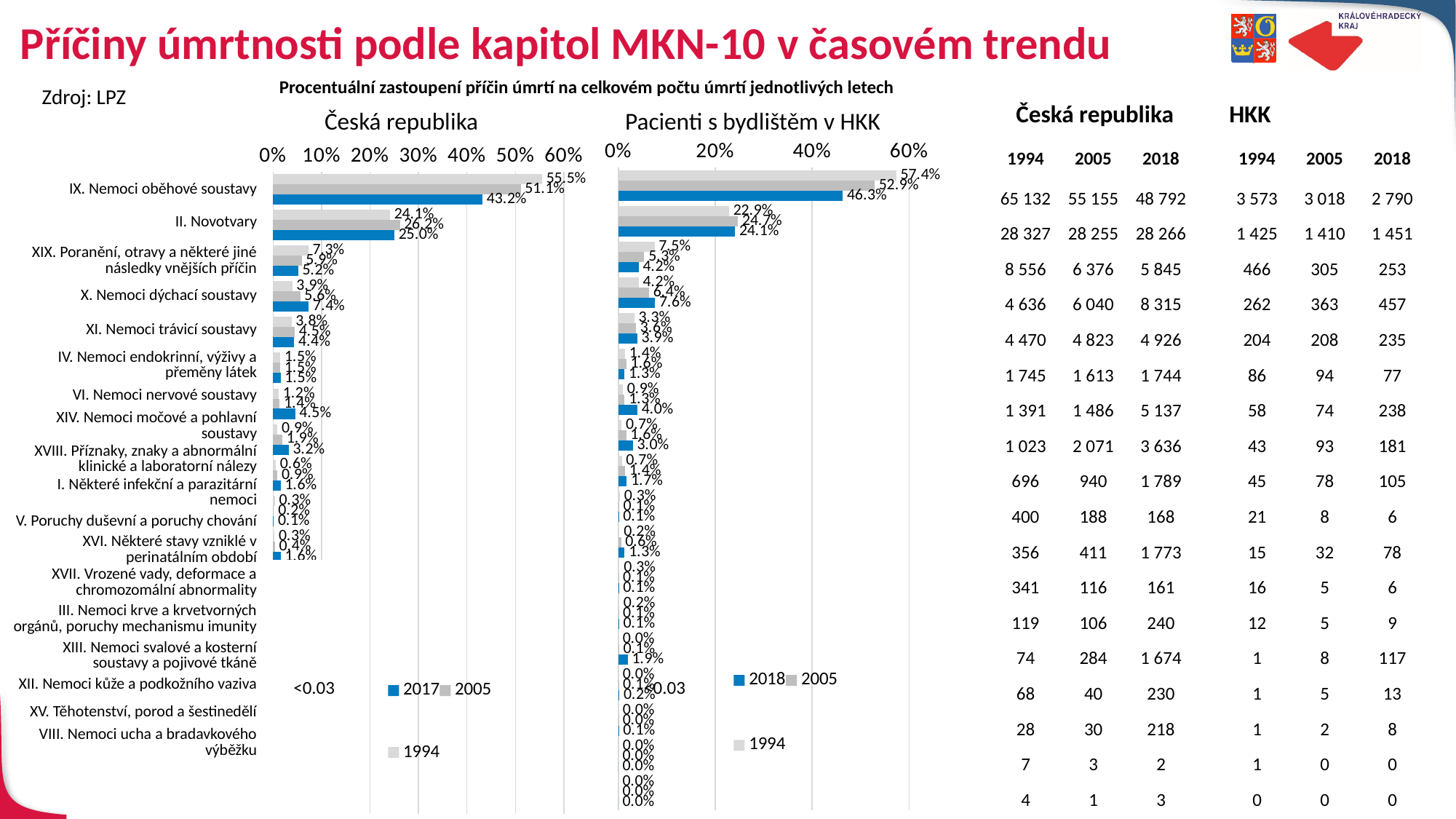
In the "Pacienti s bydlištěm v HKK" chart, does the share for X. Nemoci dýchací soustavy rise or fall from 1994 through 2005 to 2018? rise In the "Česká republika" chart, does the share for IX. Nemoci oběhové soustavy rise or fall from 1994 through 2005 to 2017? fall In the "Pacienti s bydlištěm v HKK" chart, what is the difference between the 1994 and 2018 values for IX. Nemoci oběhové soustavy? 11.1 percentage points In the "Česká republika" chart, what is the 2017 value for IX. Nemoci oběhové soustavy? 43.2% What kind of chart is the "Česká republika" chart? bar chart In the "Česká republika" chart, which is larger in 2017: X. Nemoci dýchací soustavy or XIX. Poranění, otravy a některé jiné následky vnějších příčin? X. Nemoci dýchací soustavy In the "Česká republika" chart, which category has the highest 2017 value? IX. Nemoci oběhové soustavy In the "Pacienti s bydlištěm v HKK" chart, what is the 1994 value for II. Novotvary? 22.9% In the "Pacienti s bydlištěm v HKK" chart, what is the 2018 value for IX. Nemoci oběhové soustavy? 46.3% Which years are listed in the legend of the "Pacienti s bydlištěm v HKK" chart? 2018, 2005, 1994 How many series does the legend of the "Česká republika" chart list? 3 In the "Česká republika" chart, what is the difference between the 1994 and 2017 values for IX. Nemoci oběhové soustavy? 12.3 percentage points